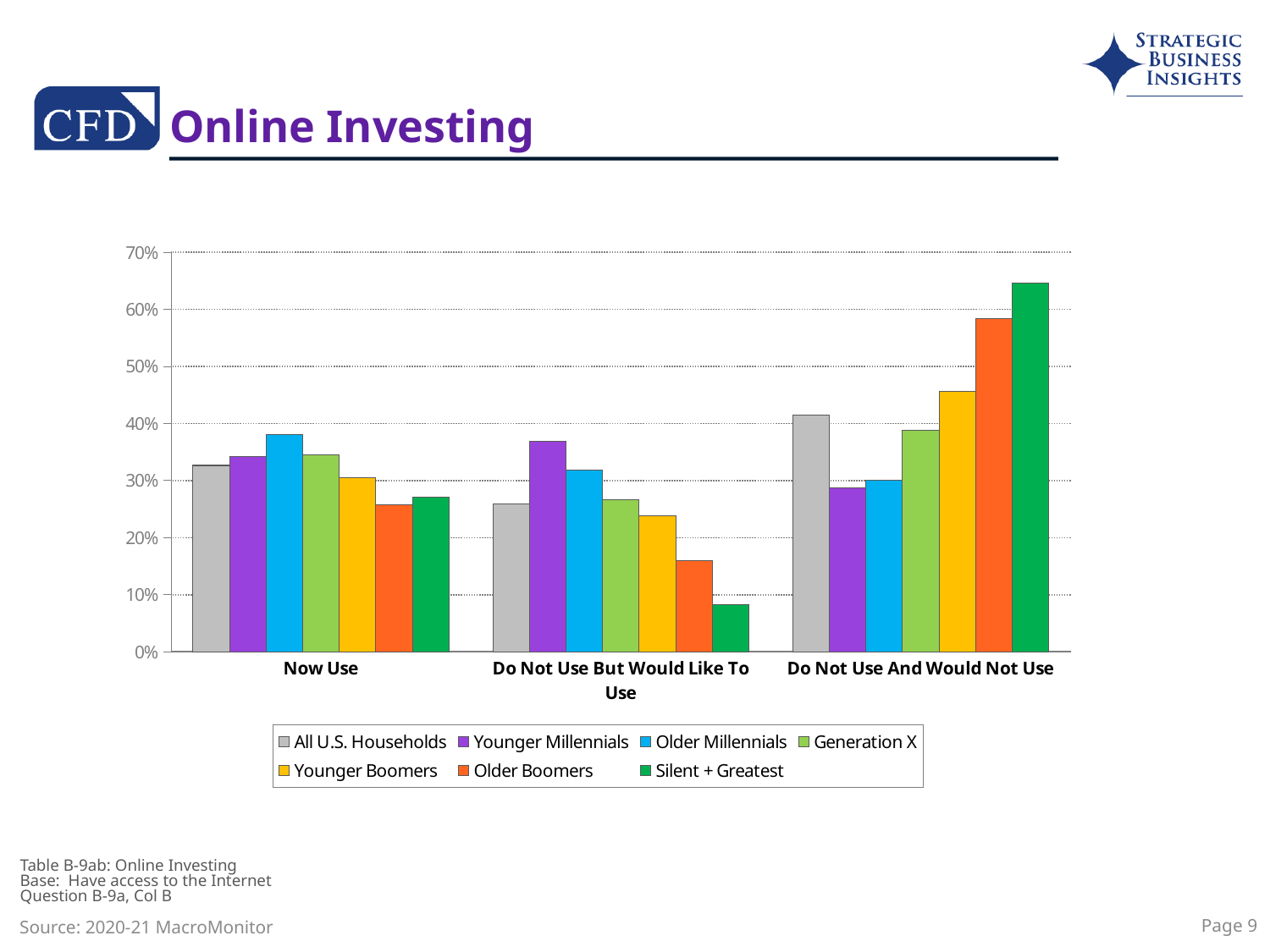
Which series has the highest value in the "Do Not Use And Would Not Use" category? Silent + Greatest What kind of chart is shown on the slide? Bar chart What is the title of the slide? Online Investing What colour represents the Silent + Greatest series in the legend? Green Which series has the lowest value in the "Do Not Use But Would Like To Use" category? Silent + Greatest Is the value for Older Boomers in the "Do Not Use But Would Like To Use" category greater or less than 20%? less Which series has the highest value in the "Now Use" category? Older Millennials How many categories are shown on the x axis? 3 Is the value for All U.S. Households in the "Do Not Use And Would Not Use" category greater or less than 40%? greater How many series does the legend list? 7 Is the value for Silent + Greatest in the "Do Not Use And Would Not Use" category greater or less than 60%? greater In the "Do Not Use But Would Like To Use" category, which is larger: Younger Millennials or Older Millennials? Younger Millennials